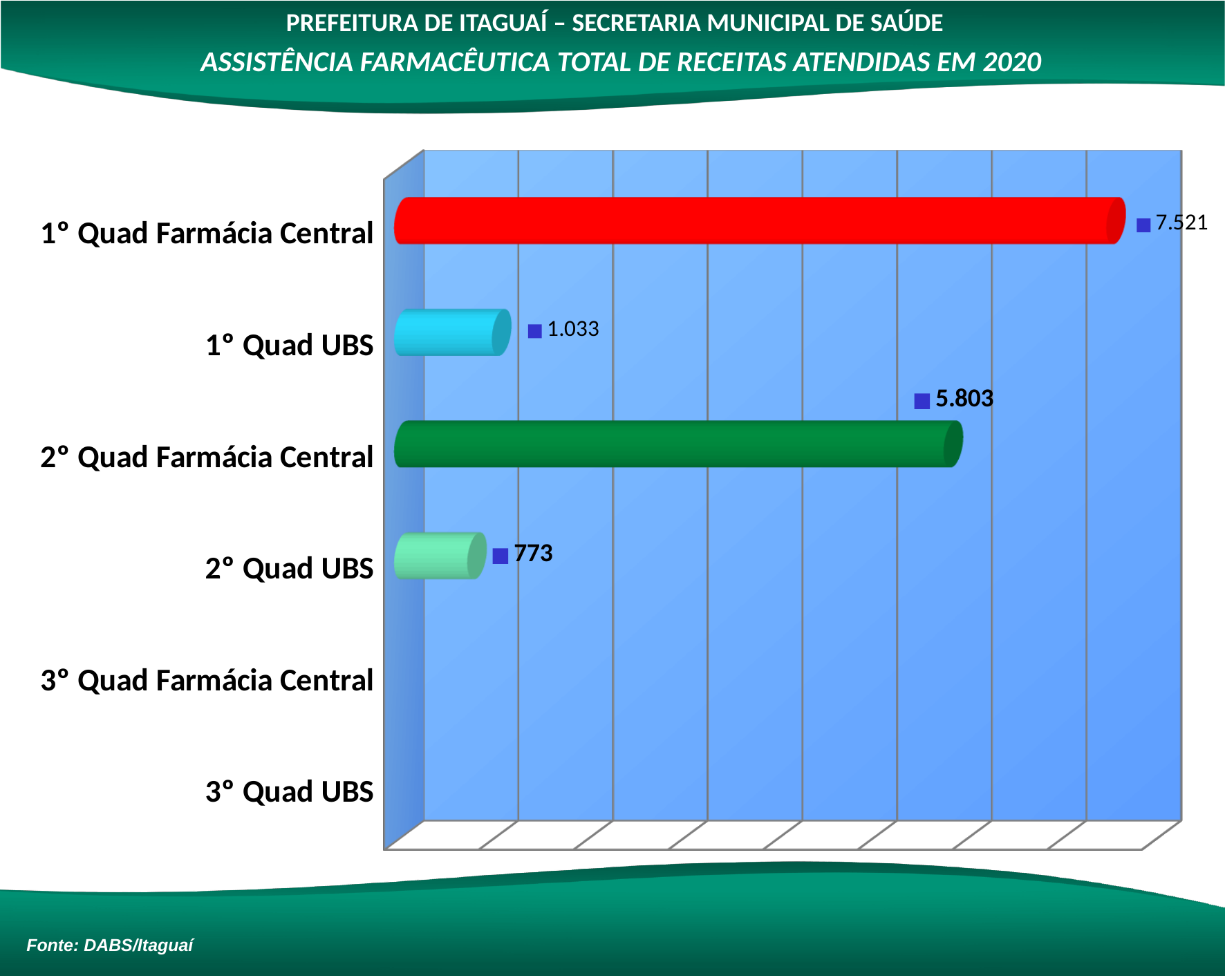
What is the value for 1° Quad Farmácia Central? 7.521 What colour is the bar for 2° Quad Farmácia Central? Green How many categories are listed on the vertical axis? 6 What is the value for 2° Quad Farmácia Central? 5.803 What is the difference between the values for 1° Quad UBS and 2° Quad UBS? 260 Which is larger, the value for 1° Quad UBS or the value for 2° Quad UBS? 1° Quad UBS What is the difference between the values for 1° Quad Farmácia Central and 2° Quad Farmácia Central? 1.718 What is the value for 2° Quad UBS? 773 Which category has the highest value? 1° Quad Farmácia Central What is the value for 1° Quad UBS? 1.033 Among the categories with a plotted bar, which has the lowest value? 2° Quad UBS What kind of chart is shown on the slide? Bar chart